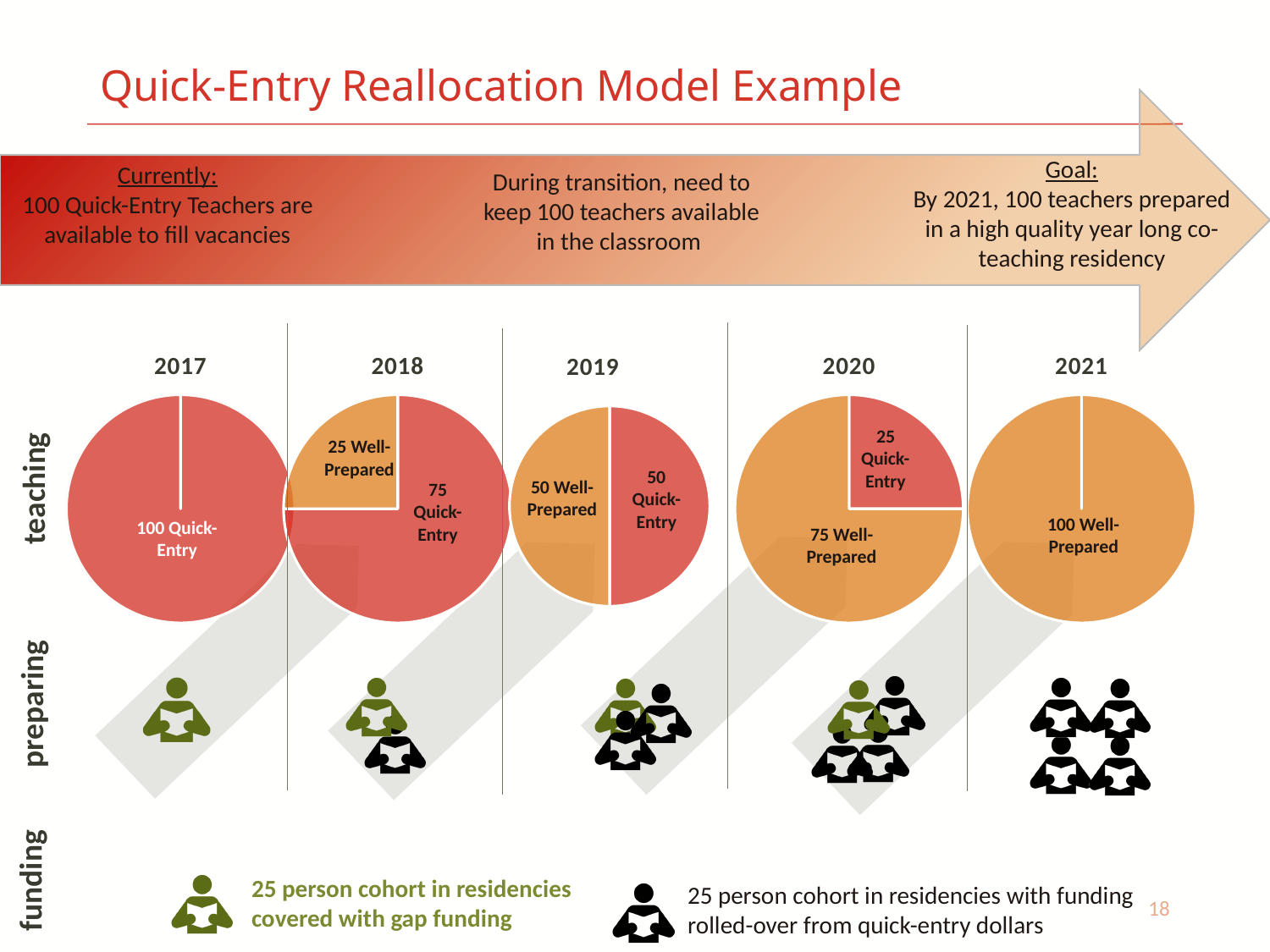
In the 2017 pie chart, how many Quick-Entry teachers are shown? 100 Quick-Entry In the 2018 pie chart, what is the value for Well-Prepared teachers? 25 Well-Prepared In the 2020 pie chart, what is the value for Quick-Entry teachers? 25 Quick-Entry In the 2021 pie chart, what is the value for Well-Prepared teachers? 100 Well-Prepared In the 2019 pie chart, what share of the pie is Well-Prepared? 50% In the 2018 pie chart, what is the value for Quick-Entry teachers? 75 Quick-Entry What kind of chart is used for each year from 2017 to 2021? Pie chart In the 2019 pie chart, what is the value for Well-Prepared teachers? 50 Well-Prepared In the 2018 pie chart, what is the difference between the Quick-Entry and Well-Prepared values? 50 Across the pie charts from 2017 to 2021, does the number of Well-Prepared teachers rise or fall over time? Rise In the 2020 pie chart, which slice is larger, Well-Prepared or Quick-Entry? Well-Prepared In the 2018 pie chart, which slice is larger, Well-Prepared or Quick-Entry? Quick-Entry